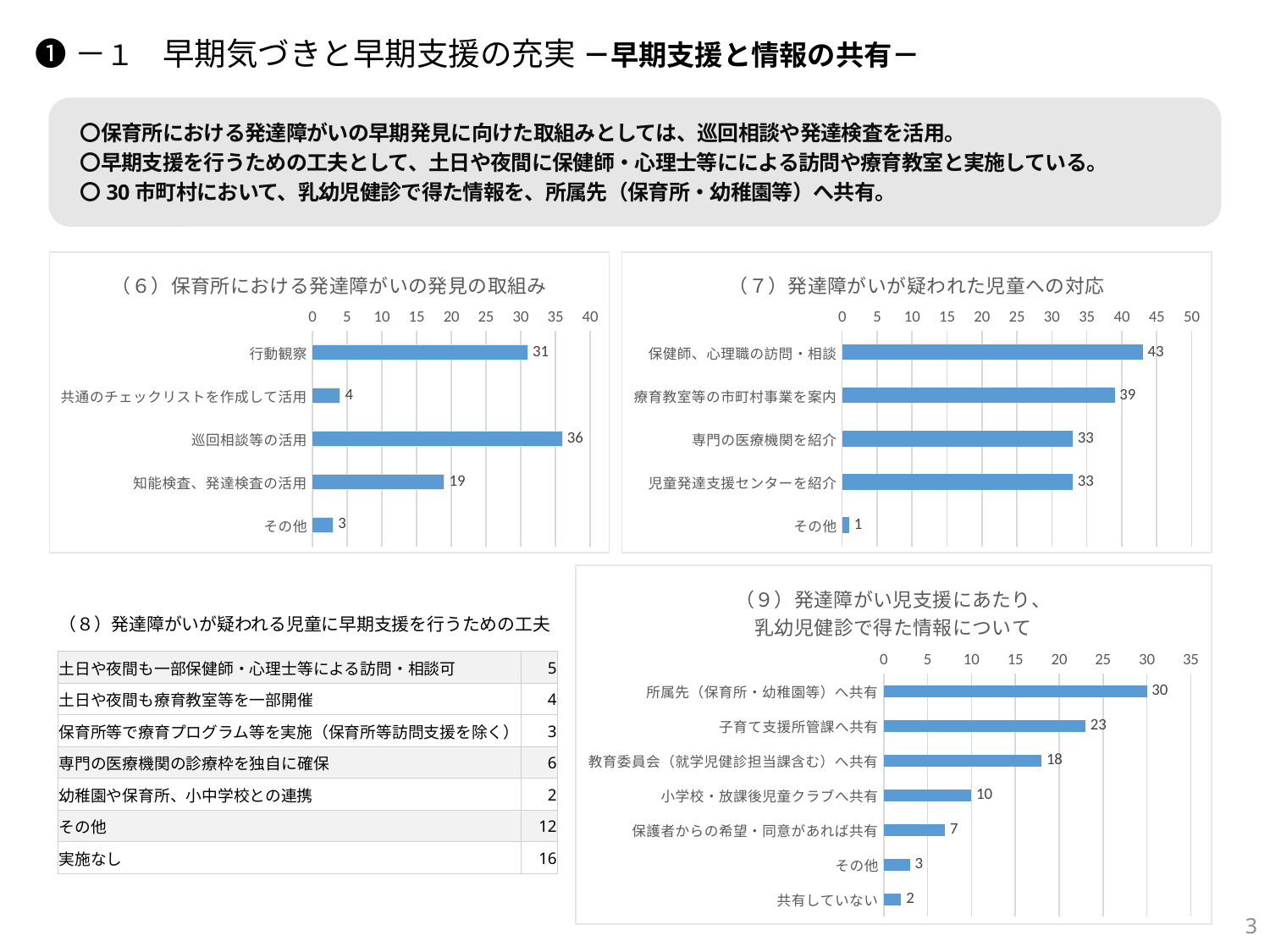
In the chart titled （7）発達障がいが疑われた児童への対応, which category has the lowest value? その他 In the chart titled （9）発達障がい児支援にあたり、乳幼児健診で得た情報について, how many categories are plotted? 7 In the chart titled （7）発達障がいが疑われた児童への対応, what is the value for 保健師、心理職の訪問・相談? 43 In the chart titled （6）保育所における発達障がいの発見の取組み, what is the value for 巡回相談等の活用? 36 In the chart titled （9）発達障がい児支援にあたり、乳幼児健診で得た情報について, which category has the highest value? 所属先（保育所・幼稚園等）へ共有 In the chart titled （6）保育所における発達障がいの発見の取組み, what is the difference between 行動観察 and 知能検査、発達検査の活用? 12 What kind of chart is （7）発達障がいが疑われた児童への対応? bar chart In the chart titled （9）発達障がい児支援にあたり、乳幼児健診で得た情報について, what is the difference between 所属先（保育所・幼稚園等）へ共有 and 共有していない? 28 In the chart titled （7）発達障がいが疑われた児童への対応, which is larger: 療育教室等の市町村事業を案内 or 専門の医療機関を紹介? 療育教室等の市町村事業を案内 In the chart titled （6）保育所における発達障がいの発見の取組み, which category has the highest value? 巡回相談等の活用 In the chart titled （6）保育所における発達障がいの発見の取組み, how many categories are plotted? 5 In the chart titled （9）発達障がい児支援にあたり、乳幼児健診で得た情報について, what is the value for 子育て支援所管課へ共有? 23